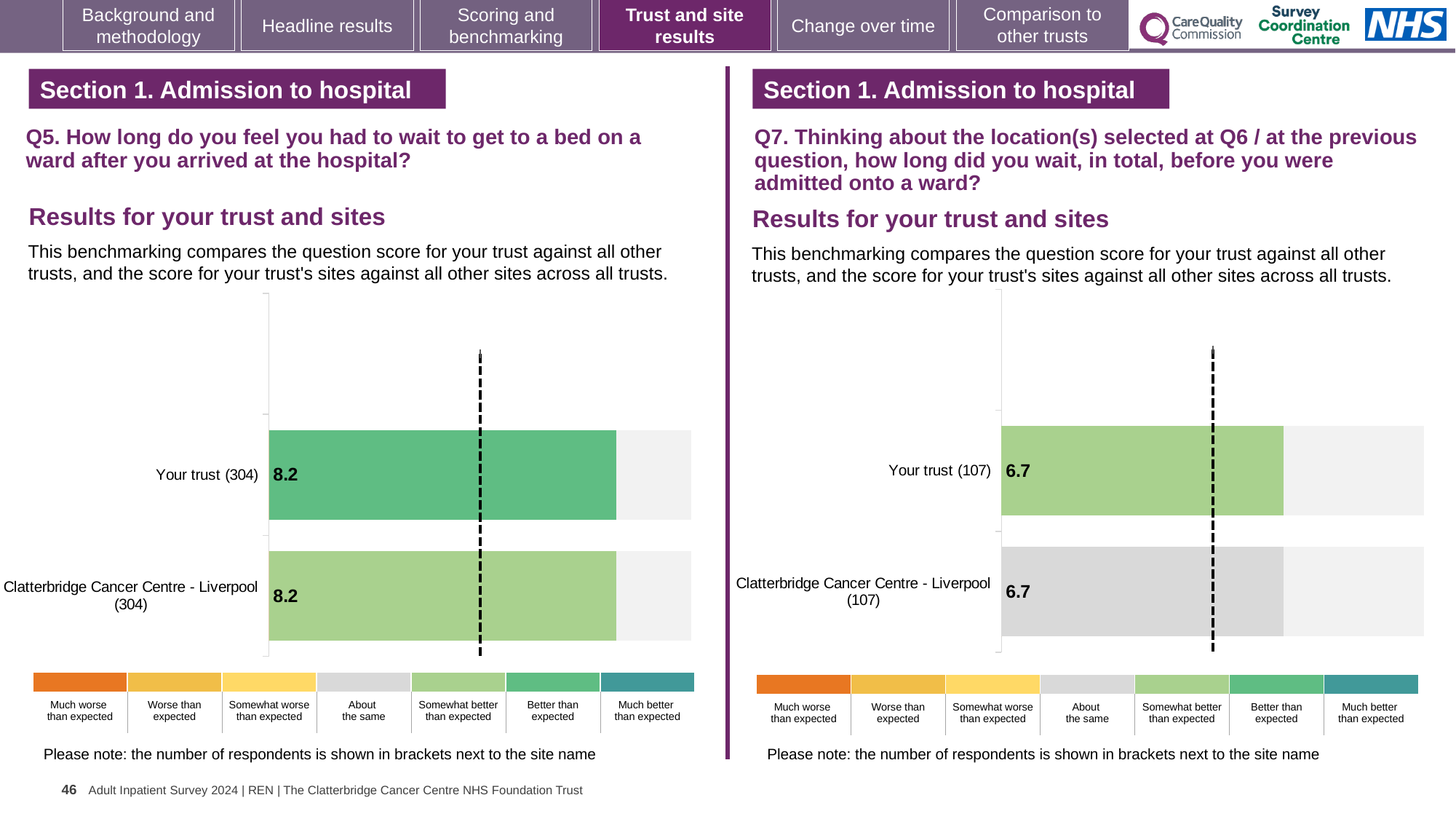
On the left chart (Q5), what is the difference between the score for Your trust and the score for Clatterbridge Cancer Centre - Liverpool? 0 How many bars are plotted on the left chart (Q5)? 2 On the right chart (Q7), how many respondents are shown in brackets for Clatterbridge Cancer Centre - Liverpool? 107 On the left chart (Q5), what is the score for Clatterbridge Cancer Centre - Liverpool? 8.2 On the left chart (Q5), how many respondents are shown in brackets for Your trust? 304 On the right chart (Q7), what is the score for Your trust? 6.7 What kind of chart is used on the left (Q5)? Bar chart On the right chart (Q7), what is the score for Clatterbridge Cancer Centre - Liverpool? 6.7 How many bars are plotted on the right chart (Q7)? 2 On the right chart (Q7), what is the difference between the score for Your trust and the score for Clatterbridge Cancer Centre - Liverpool? 0 On the left chart (Q5), what is the score for Your trust? 8.2